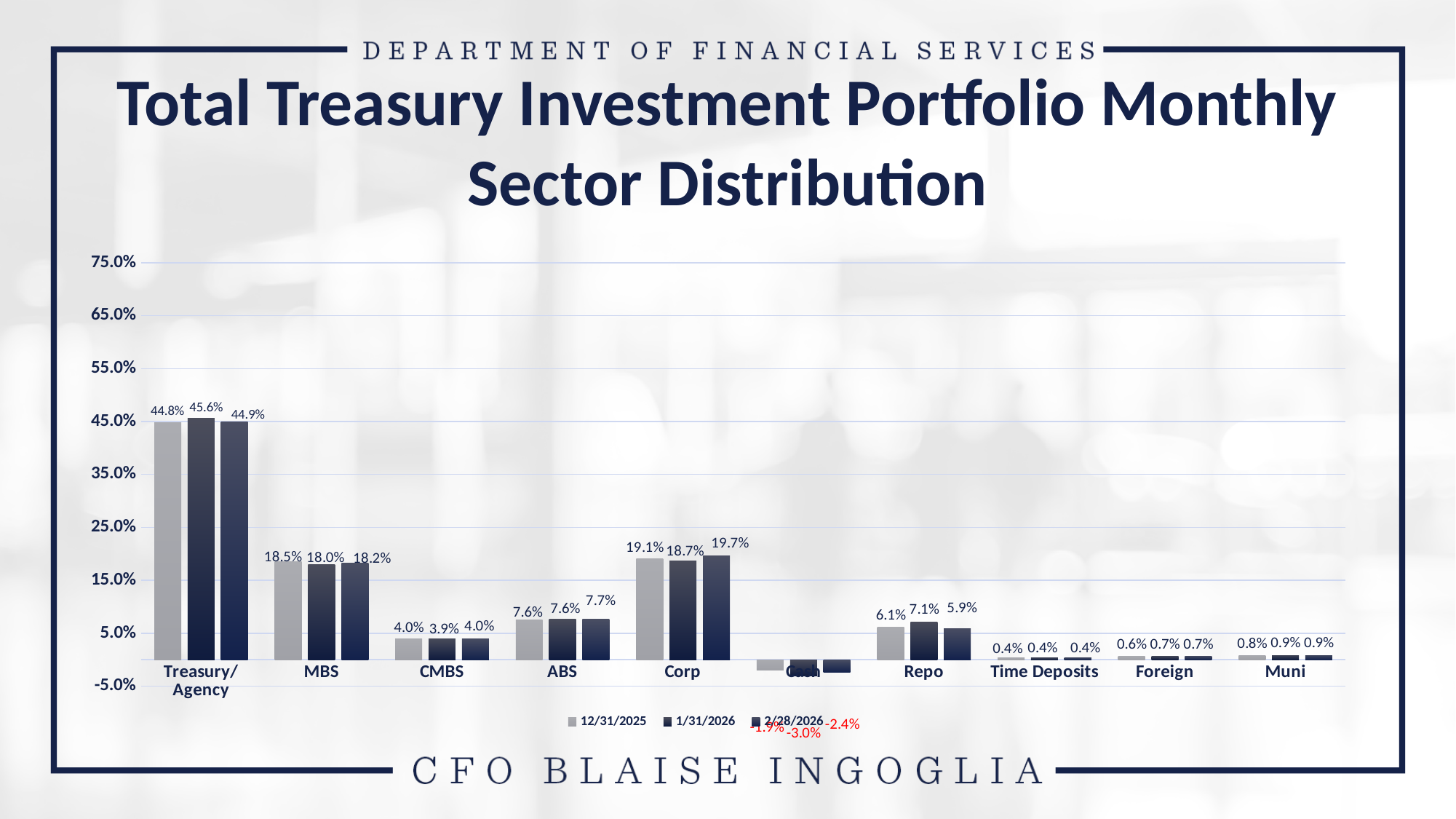
What is the value for Repo for 12/31/2025? 6.1% What is the difference between the MBS values for 12/31/2025 and 1/31/2026? 0.5% What is the value for Treasury/Agency for 1/31/2026? 45.6% What is the title of the chart? Total Treasury Investment Portfolio Monthly Sector Distribution Which is larger for 2/28/2026: the value for Corp or the value for MBS? Corp What kind of chart is shown on the slide? bar chart How many series does the legend list? 3 What is the value for Corp for 2/28/2026? 19.7% How many sector categories are shown on the x axis? 10 Which sector has the lowest value for 1/31/2026? Cash Which sector has the highest value for 2/28/2026? Treasury/Agency What is the value for Cash for 1/31/2026? -3.0%